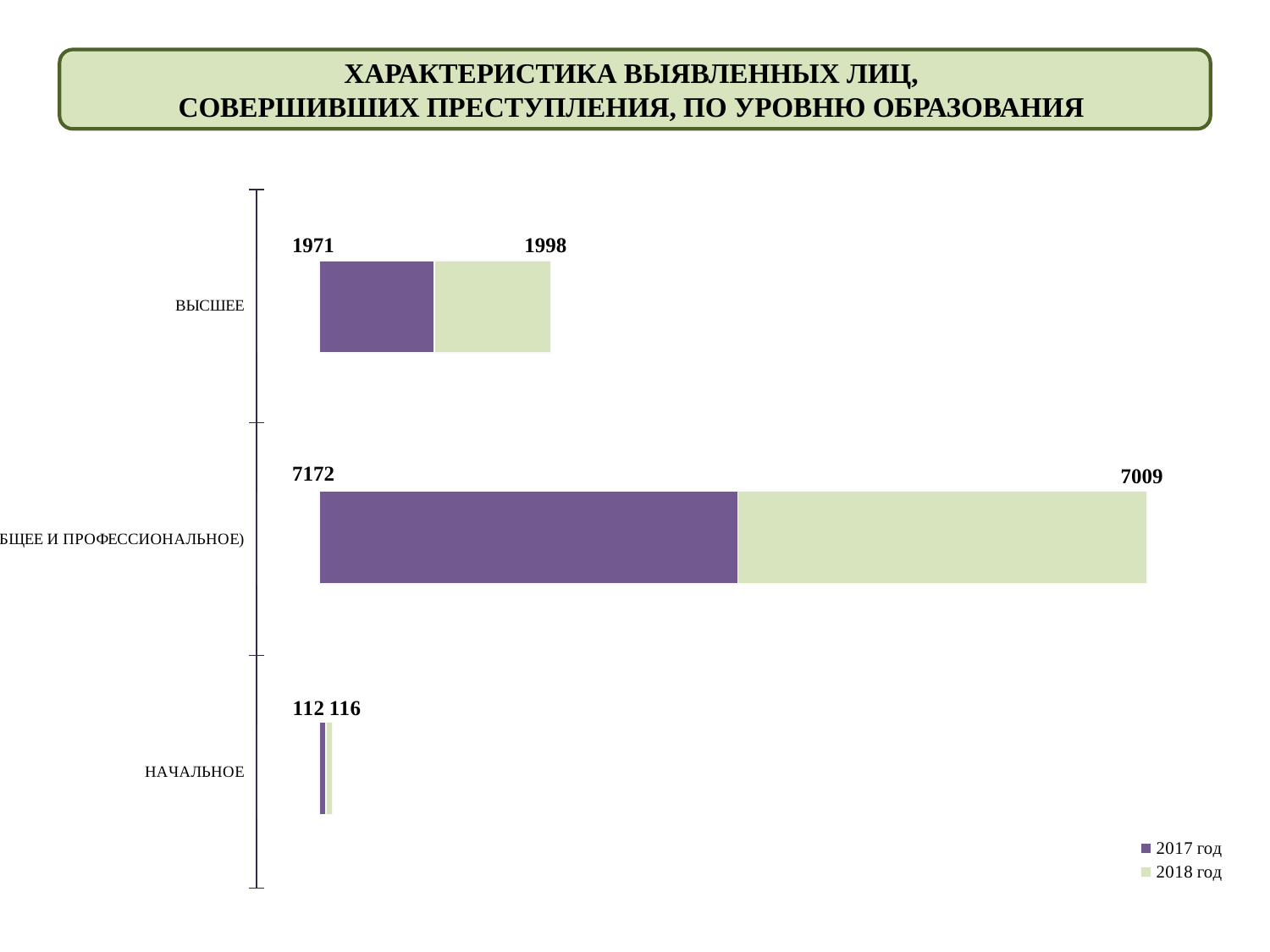
How many series does the legend list? 2 What is the difference between the 2018 год and 2017 год values for ВЫСШЕЕ? 27 What is the value for ВЫСШЕЕ in the 2018 год series? 1998 What is the 2018 год value for the middle (second) category bar? 7009 What is the value for НАЧАЛЬНОЕ in the 2017 год series? 112 Which category has the lowest value in the 2017 год series? НАЧАЛЬНОЕ What is the value for НАЧАЛЬНОЕ in the 2018 год series? 116 What is the total of the stacked bar for НАЧАЛЬНОЕ? 228 What is the value for ВЫСШЕЕ in the 2017 год series? 1971 How many categories are shown on the chart? 3 What type of chart is shown on the slide? Stacked bar chart Which series is shown in purple in the legend? 2017 год